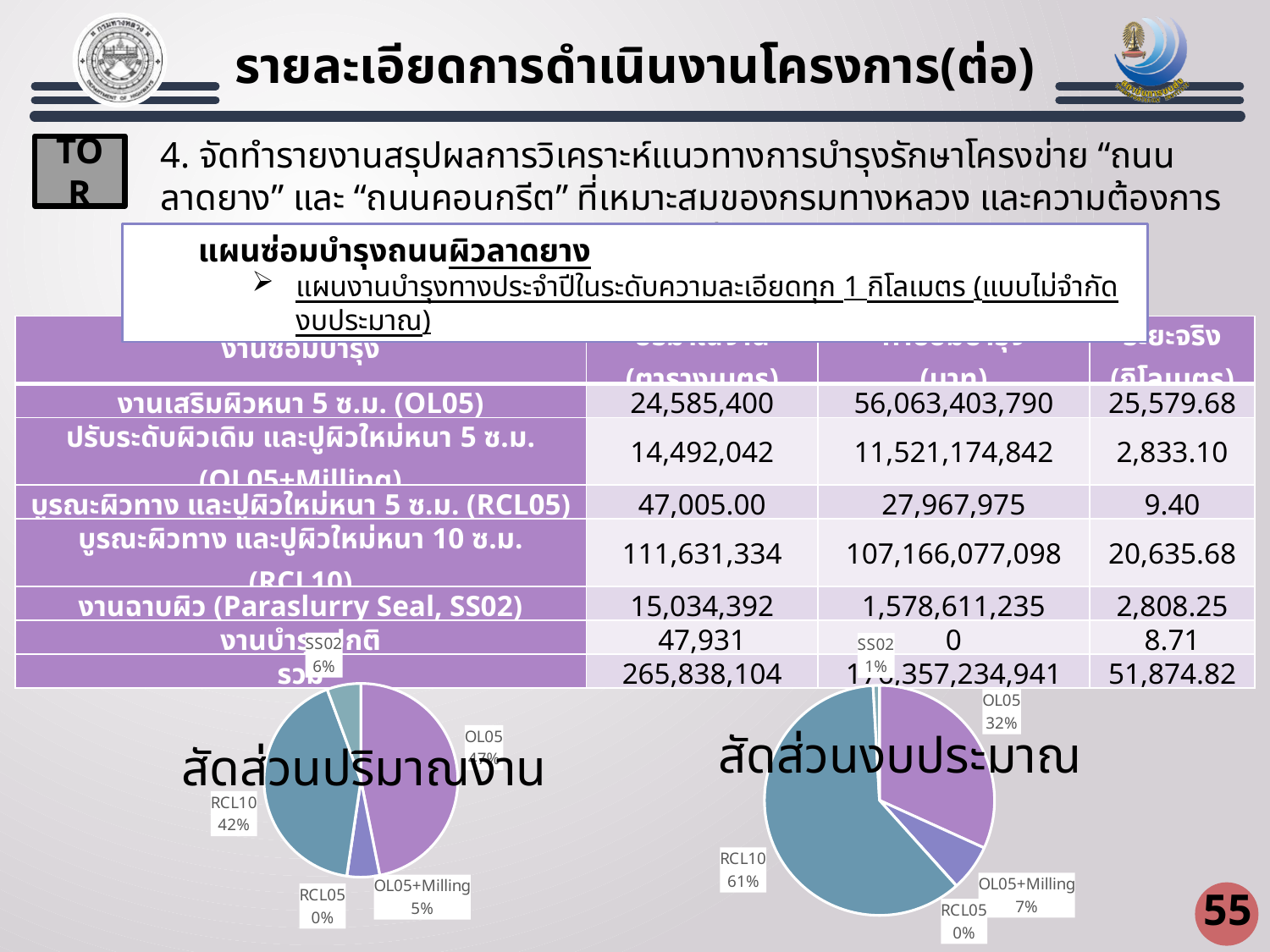
In the pie chart titled สัดส่วนงบประมาณ, what share does OL05 have? 32% In the pie chart titled สัดส่วนปริมาณงาน, what share does OL05+Milling have? 5% In the pie chart titled สัดส่วนงบประมาณ, what share does SS02 have? 1% In the pie chart titled สัดส่วนปริมาณงาน, which is larger, the share for SS02 or the share for OL05+Milling? SS02 What kind of chart is the chart titled สัดส่วนงบประมาณ? Pie chart In the pie chart titled สัดส่วนงบประมาณ, which category has the largest share? RCL10 In the pie chart titled สัดส่วนงบประมาณ, what is the difference between the RCL10 share and the OL05 share? 29%